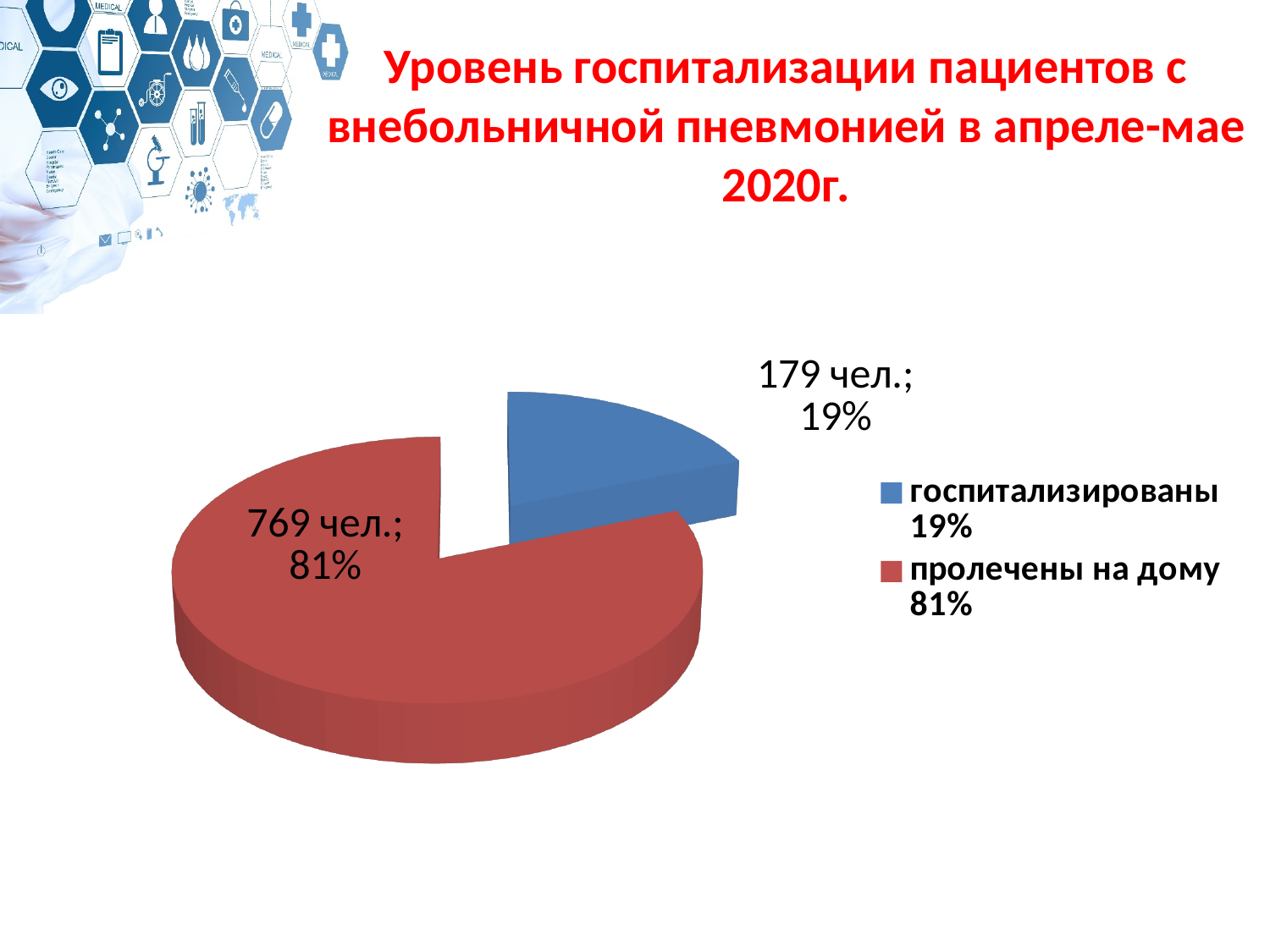
What share of the pie does the 'пролечены на дому' slice represent? 81% How many categories does the pie chart have? 2 How many people were treated at home (пролечены на дому)? 769 чел. How many people were hospitalized (госпитализированы)? 179 чел. What is the total number of people represented in the pie chart? 948 чел. What is the difference in the number of people between 'пролечены на дому' and 'госпитализированы'? 590 чел. Which category has the smallest slice of the pie? госпитализированы Which is larger: the number of people hospitalized or the number treated at home? пролечены на дому What kind of chart is shown on the slide? pie chart Which category has the largest slice of the pie? пролечены на дому What colour is the 'госпитализированы' slice? blue What share of the pie does the 'госпитализированы' slice represent? 19%